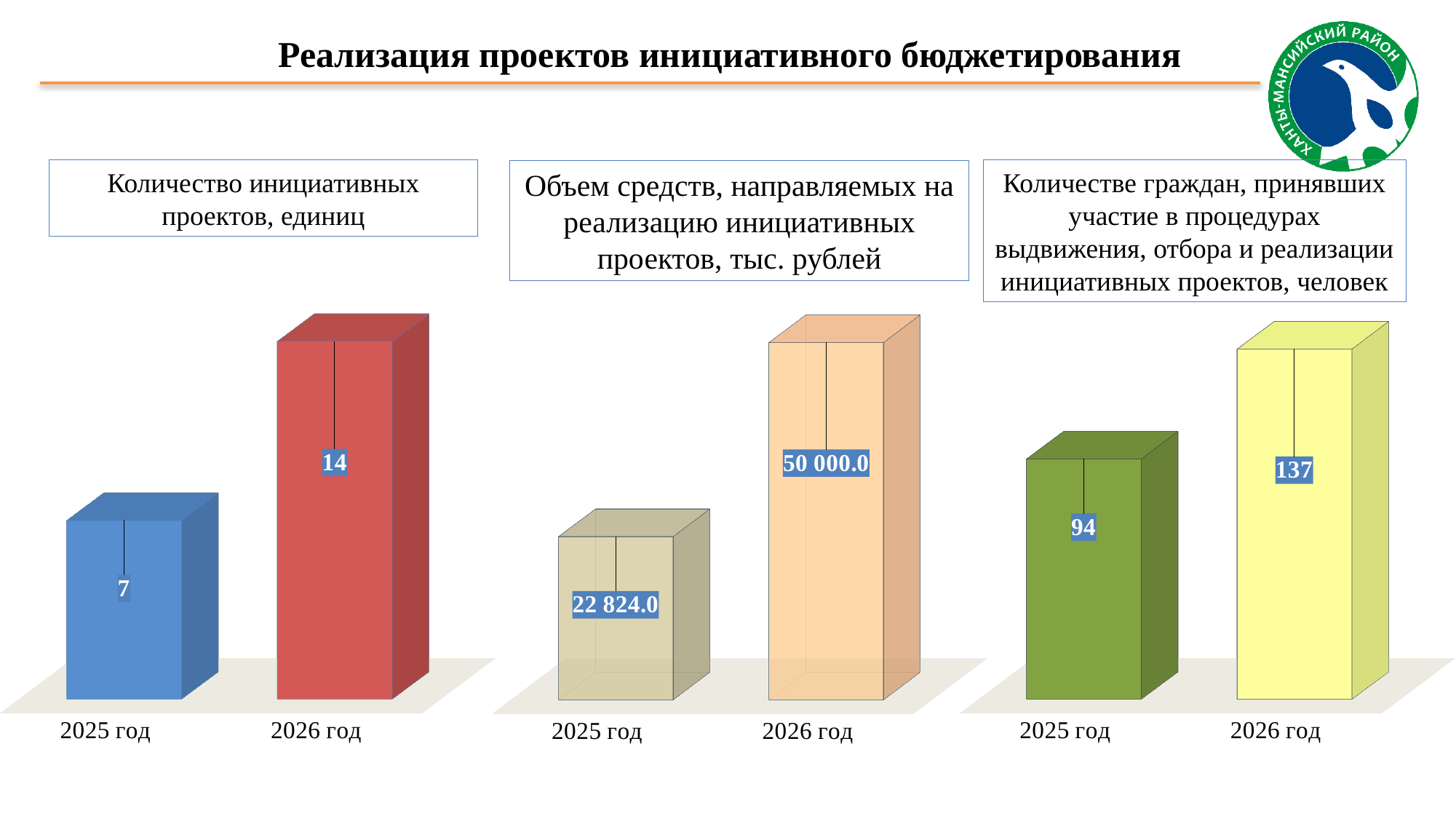
How many categories are shown on the x axis of the left chart (Количество инициативных проектов, единиц)? 2 In the left chart (Количество инициативных проектов, единиц), what is the difference between the 2026 год and 2025 год values? 7 In the right chart (Количестве граждан, принявших участие...), what is the value for 2025 год? 94 In the left chart (Количество инициативных проектов, единиц), what is the value for 2025 год? 7 In the right chart (Количестве граждан, принявших участие...), what is the value for 2026 год? 137 In the middle chart (Объем средств, направляемых на реализацию инициативных проектов, тыс. рублей), what is the value for 2025 год? 22 824.0 In the right chart (Количестве граждан, принявших участие...), what is the difference between the 2026 год and 2025 год values? 43 In the right chart (Количестве граждан, принявших участие...), which year has the lowest value? 2025 год In the left chart (Количество инициативных проектов, единиц), what is the value for 2026 год? 14 What type of chart is the middle chart (Объем средств...)? Bar chart In the middle chart (Объем средств, направляемых на реализацию инициативных проектов, тыс. рублей), what is the value for 2026 год? 50 000.0 In the middle chart (Объем средств...), which year has the higher value, 2025 год or 2026 год? 2026 год